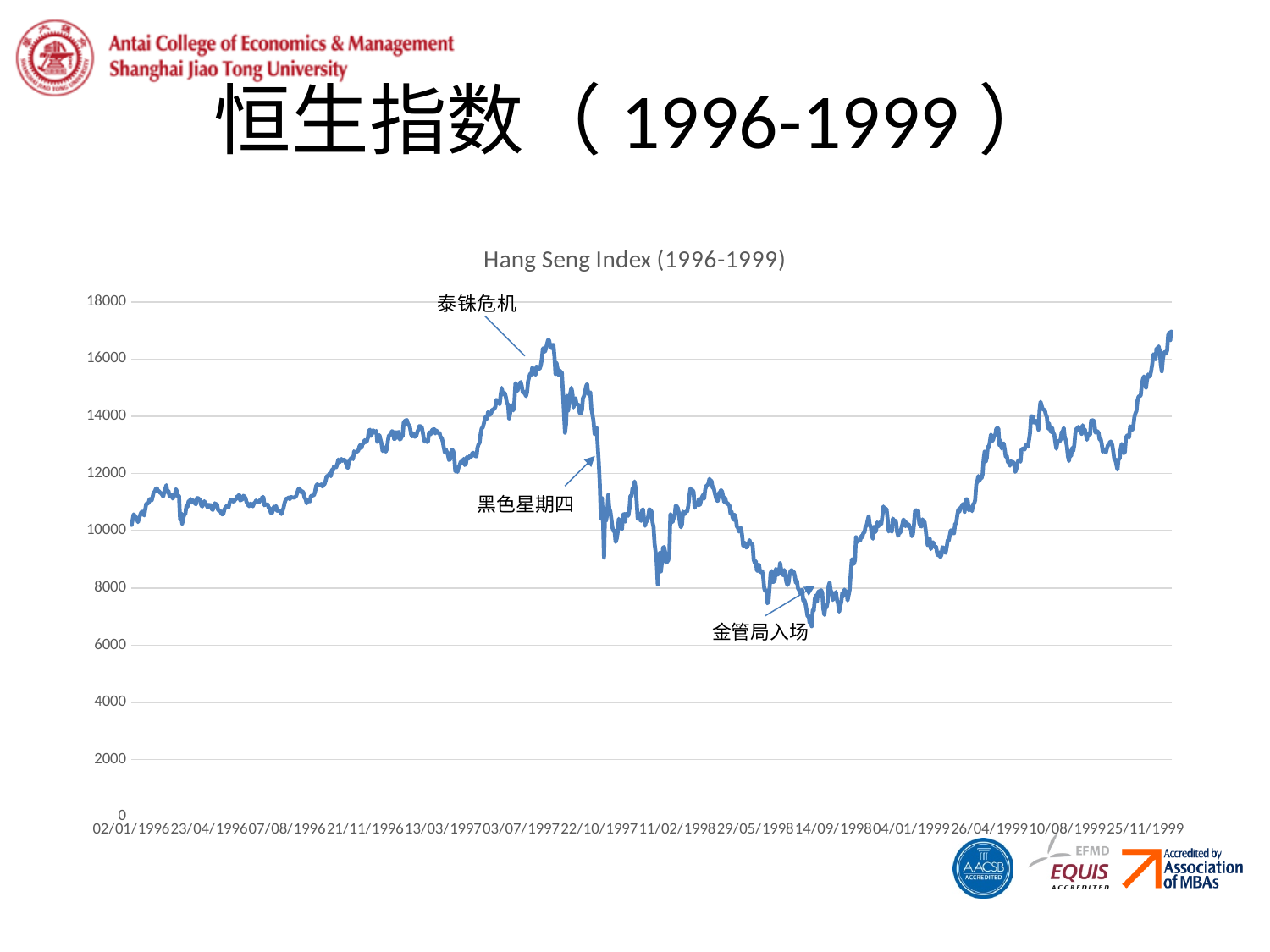
Is the index value at the point marked 金管局入场 greater or less than 8000? less Which is higher, the index at the point marked 泰铢危机 or at the point marked 金管局入场? 泰铢危机 What is the highest value shown on the vertical axis? 18000 Which is higher, the index at the start of the series (02/01/1996) or at the end (25/11/1999)? 25/11/1999 Is the index value at the end of the series (25/11/1999) greater or less than 16000? greater Is the lowest point of the index on the chart greater or less than 8000? less Does the index rise or fall from the point marked 金管局入场 to the end of the series? rise What is the title of the chart? Hang Seng Index (1996-1999) Does the index rise or fall between the point marked 泰铢危机 and the point marked 金管局入场? fall How many annotated events are marked on the chart? 3 What kind of chart is shown on the slide? line chart